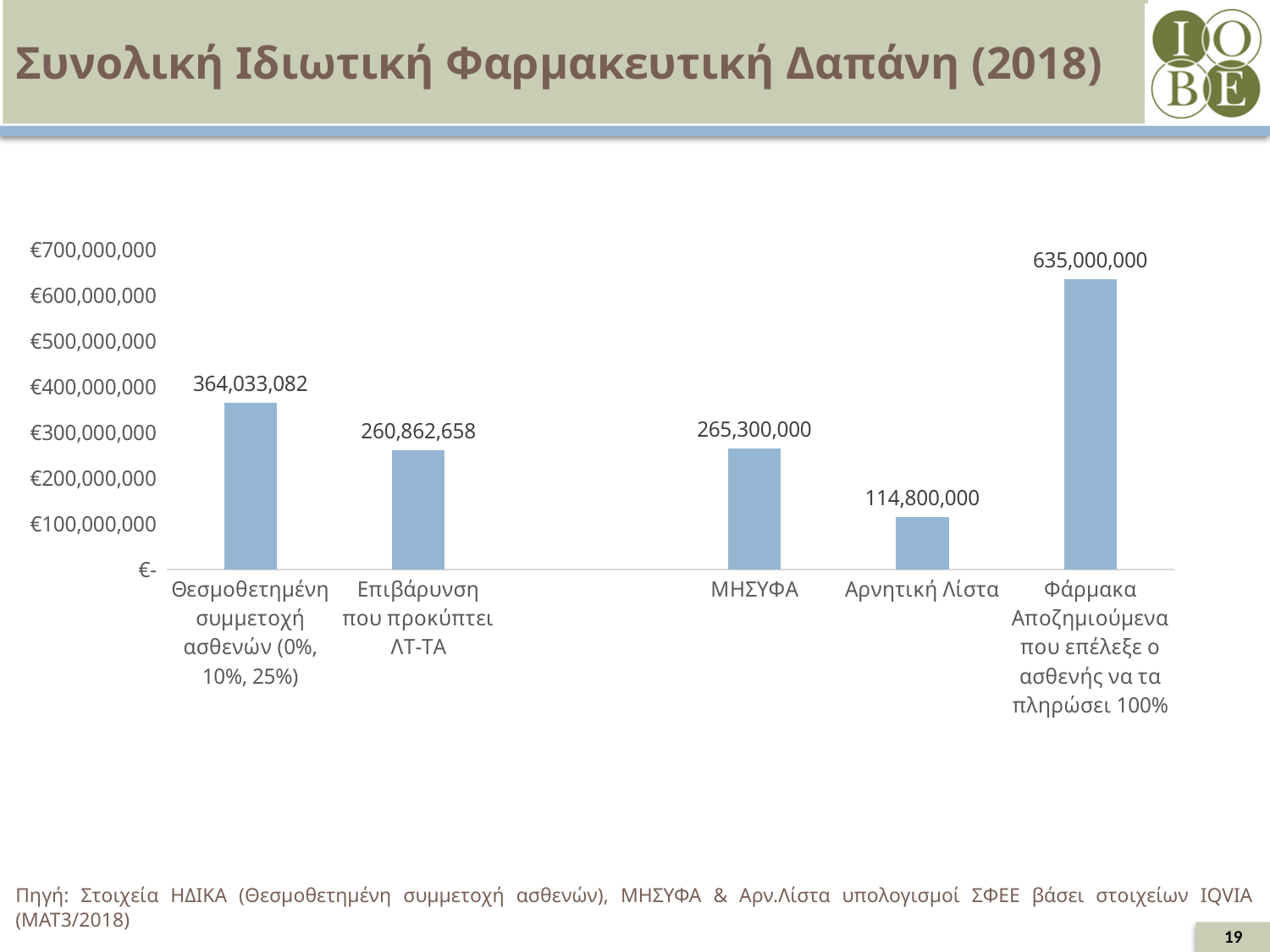
What is the difference between the value for Φάρμακα Αποζημιούμενα που επέλεξε ο ασθενής να τα πληρώσει 100% and the value for Αρνητική Λίστα? 520,200,000 What is the value for Θεσμοθετημένη συμμετοχή ασθενών (0%, 10%, 25%)? 364,033,082 Which category has the lowest value? Αρνητική Λίστα What is the value for ΜΗΣΥΦΑ? 265,300,000 What kind of chart is shown on the slide? bar chart Is the value for Αρνητική Λίστα greater or less than €200,000,000? less Which is larger, the value for ΜΗΣΥΦΑ or the value for Επιβάρυνση που προκύπτει ΛΤ-ΤΑ? ΜΗΣΥΦΑ How many bars are plotted in the chart? 5 Which category has the highest value? Φάρμακα Αποζημιούμενα που επέλεξε ο ασθενής να τα πληρώσει 100% What is the difference between the value for Θεσμοθετημένη συμμετοχή ασθενών (0%, 10%, 25%) and the value for Επιβάρυνση που προκύπτει ΛΤ-ΤΑ? 103,170,424 What is the value for Αρνητική Λίστα? 114,800,000 What is the value for Φάρμακα Αποζημιούμενα που επέλεξε ο ασθενής να τα πληρώσει 100%? 635,000,000